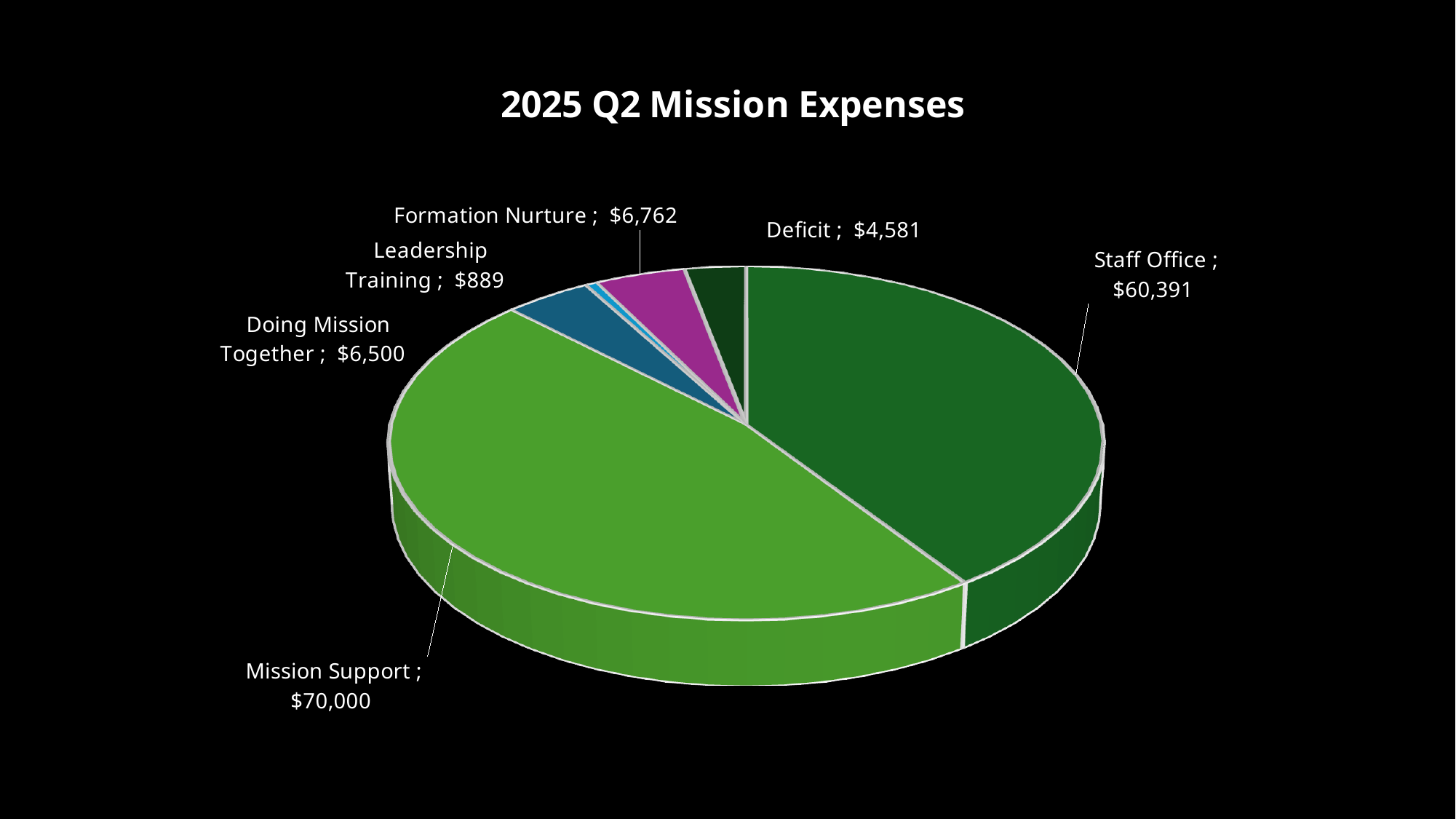
What type of chart is shown on the slide? pie chart What is the difference between Mission Support and Staff Office? $9,609 What is the value for Staff Office? $60,391 What is the value for Mission Support? $70,000 Which category has the largest slice? Mission Support What is the value for Leadership Training? $889 What is the title of the chart? 2025 Q2 Mission Expenses How many slices does the pie chart have? 6 Which category has the smallest slice? Leadership Training Which is larger, Formation Nurture or Doing Mission Together? Formation Nurture What is the difference between Deficit and Leadership Training? $3,692 What is the value for Deficit? $4,581